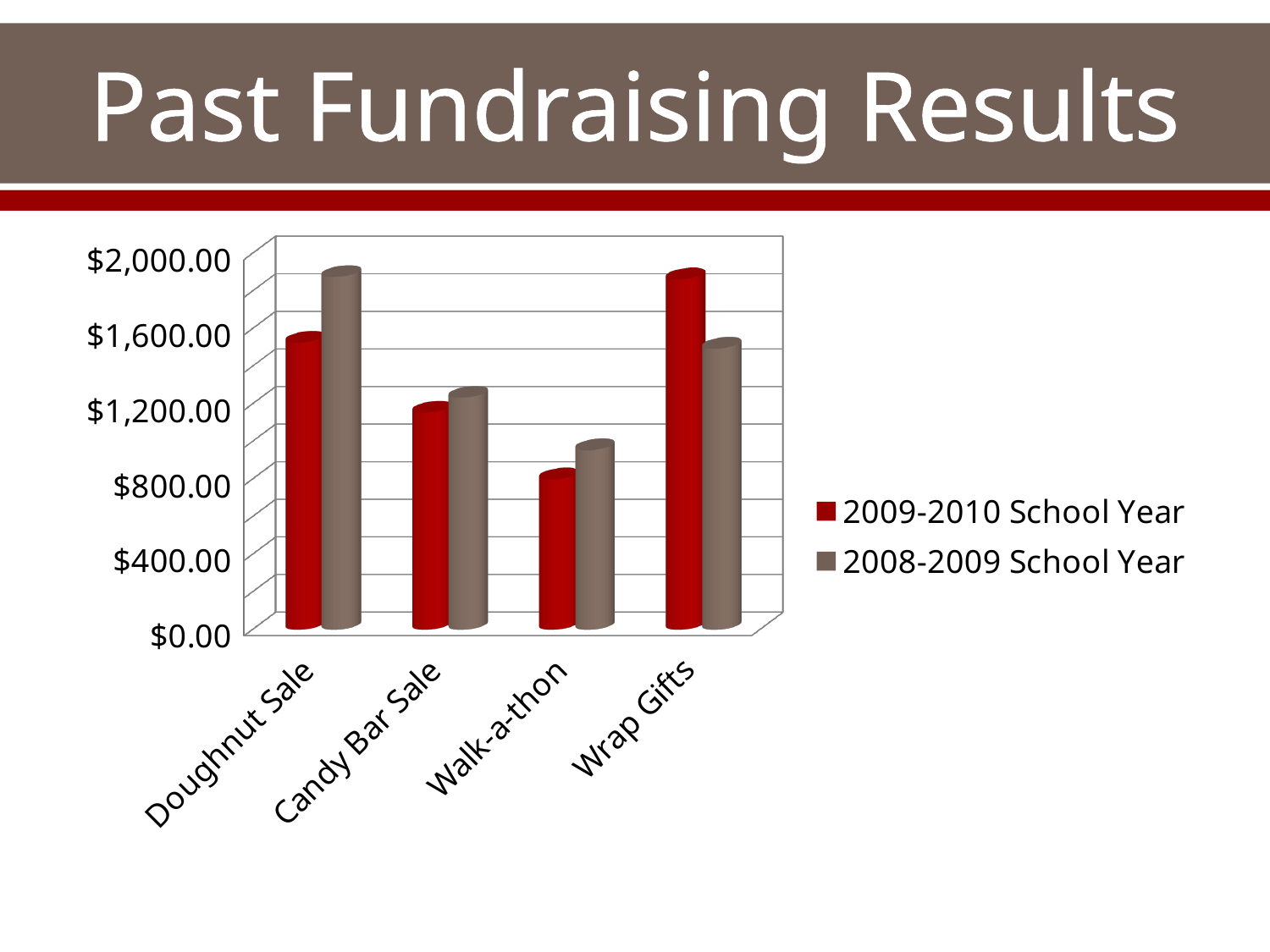
How many series does the legend list? 2 What kind of chart is shown on the slide? bar chart For the Doughnut Sale, which school year had the larger value? 2008-2009 School Year What is the title of the chart? Past Fundraising Results Which fundraiser had the highest value in the 2009-2010 School Year? Wrap Gifts Which fundraiser had the highest value in the 2008-2009 School Year? Doughnut Sale Which colour represents the 2009-2010 School Year series? red Is the value for the Doughnut Sale in the 2008-2009 School Year greater or less than $1,600.00? greater Which fundraiser had the lowest value in the 2009-2010 School Year? Walk-a-thon Is the value for the Walk-a-thon in the 2009-2010 School Year greater or less than $1,200.00? less How many fundraising categories are shown on the x axis? 4 For Wrap Gifts, which school year had the larger value? 2009-2010 School Year